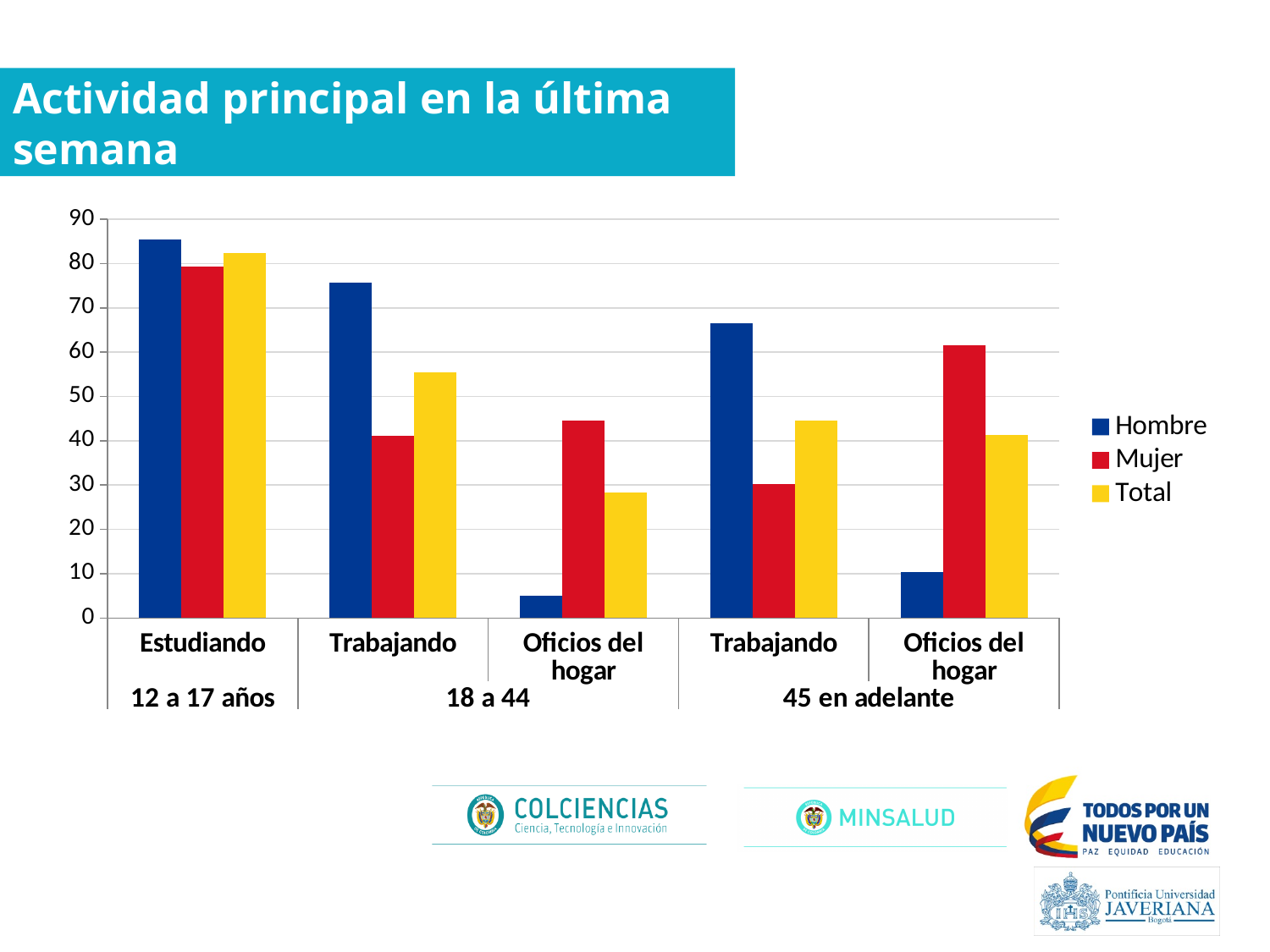
What kind of chart is shown on the slide? bar chart Which category has the highest Hombre value? Estudiando (12 a 17 años) Which category has the lowest Hombre value? Oficios del hogar (18 a 44) Which category has the highest Mujer value? Estudiando (12 a 17 años) How many activity categories are shown along the x axis? 5 Is the Total value for Oficios del hogar (18 a 44) greater or less than 40? less How many series does the legend list? 3 For Oficios del hogar (45 en adelante), which is larger, the Hombre value or the Mujer value? Mujer For Trabajando (18 a 44), which is larger, the Hombre value or the Mujer value? Hombre Is the Hombre value for Trabajando (18 a 44) greater or less than 70? greater What is the title of the slide containing the chart? Actividad principal en la última semana Is the Mujer value for Oficios del hogar (45 en adelante) greater or less than 50? greater